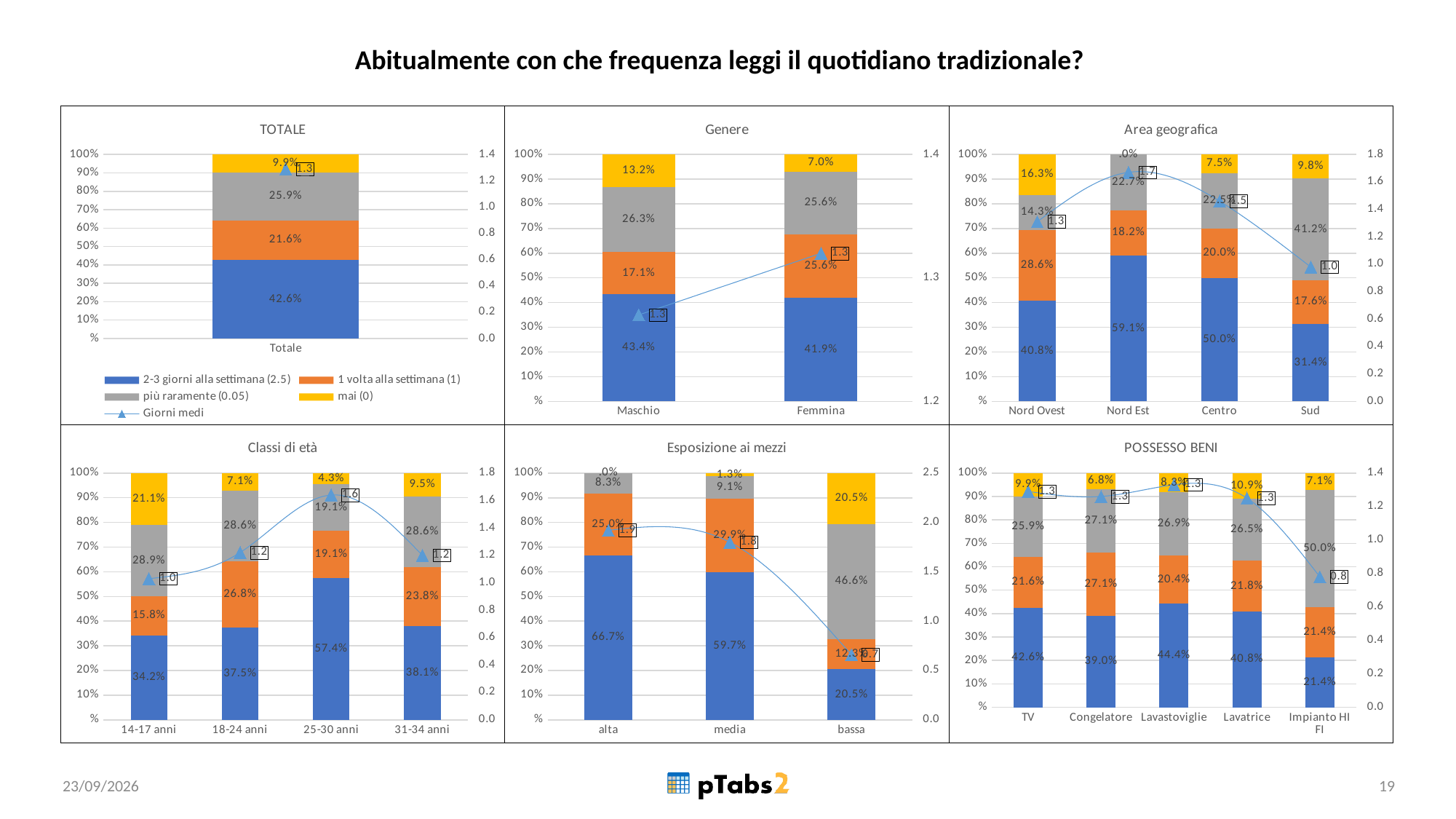
In the Genere chart, which category has the larger '1 volta alla settimana (1)' share, Maschio or Femmina? Femmina How many series does the legend in the TOTALE chart list? 5 In the Area geografica chart, what is the 'Giorni medi' value for Sud? 1.0 In the Area geografica chart, what is the difference between the '2-3 giorni alla settimana (2.5)' shares of Nord Est and Sud? 27.7% In the TOTALE chart, what percentage is shown for the '2-3 giorni alla settimana (2.5)' segment? 42.6% In the Classi di età chart, which age class has the lowest 'Giorni medi' value? 14-17 anni In the POSSESSO BENI chart, what is the 'Giorni medi' value for Impianto HI FI? 0.8 In the Genere chart, what is the 'mai (0)' percentage for Maschio? 13.2% In the Esposizione ai mezzi chart, what is the 'più raramente (0.05)' percentage for bassa? 46.6% In the Esposizione ai mezzi chart, do the 'Giorni medi' values rise or fall from alta to bassa? fall In the Classi di età chart, how many age classes are shown on the x axis? 4 In the Area geografica chart, which area has the highest 'Giorni medi' value? Nord Est